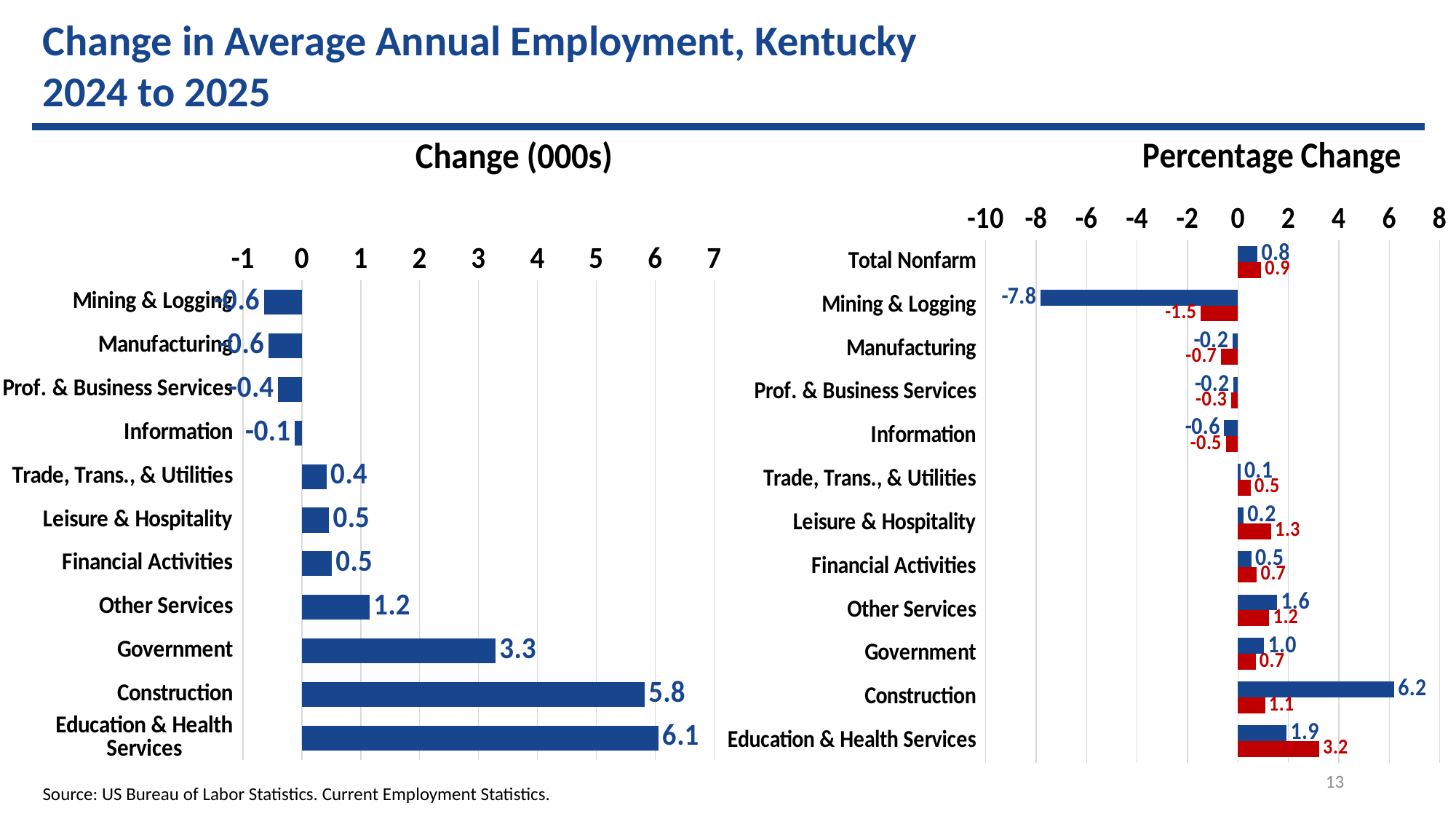
In the Change (000s) chart, what is the value for Government? 3.3 In the Change (000s) chart, which category has the highest value? Education & Health Services In the Change (000s) chart, what is the difference between Education & Health Services and Construction? 0.3 In the Change (000s) chart, what is the value for Construction? 5.8 In the Percentage Change chart, what is the blue bar value for Mining & Logging? -7.8 In the Change (000s) chart, how many categories are shown? 11 In the Change (000s) chart, which category has the lowest value? Mining & Logging and Manufacturing (tied at -0.6) What type of chart is the Change (000s) chart? bar chart In the Percentage Change chart, what is the red bar value for Education & Health Services? 3.2 In the Percentage Change chart, which category has the highest blue bar value? Construction In the Percentage Change chart, how many categories are shown? 12 In the Percentage Change chart, which is larger for Other Services, the blue bar or the red bar? the blue bar